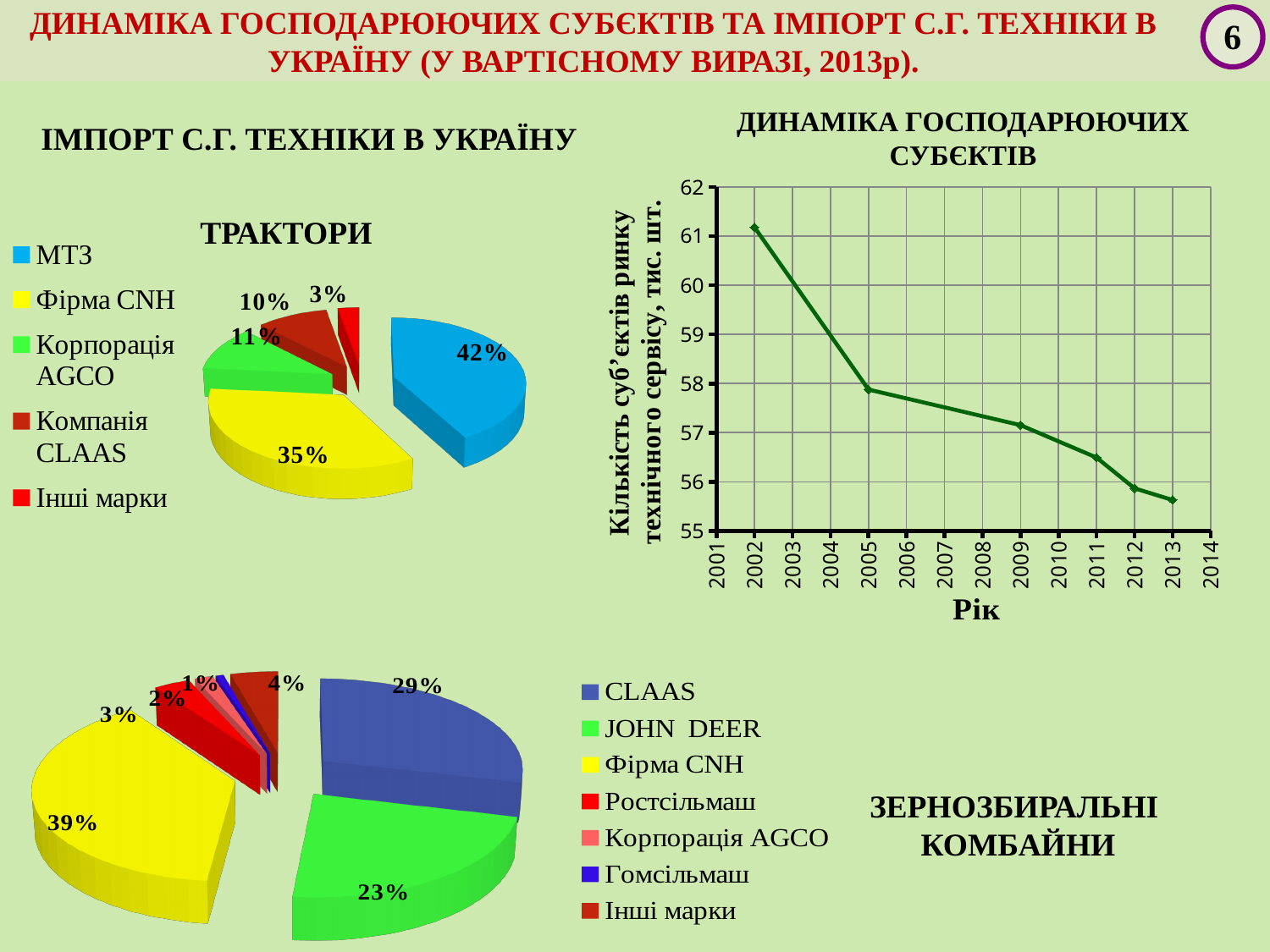
In the ТРАКТОРИ pie chart, what is the difference between the shares of МТЗ and Фірма CNH? 7% In the ЗЕРНОЗБИРАЛЬНІ КОМБАЙНИ pie chart, which brand has the largest share? Фірма CNH In the ДИНАМІКА ГОСПОДАРЮЮЧИХ СУБЄКТІВ chart, is the value for 2002 greater or less than 61? greater In the ЗЕРНОЗБИРАЛЬНІ КОМБАЙНИ pie chart, which is larger: the share of CLAAS or the share of JOHN DEER? CLAAS In the ДИНАМІКА ГОСПОДАРЮЮЧИХ СУБЄКТІВ chart, do the values rise or fall from 2002 to 2013? Fall In the ТРАКТОРИ pie chart, what share does Корпорація AGCO have? 11% How many entries does the legend of the ЗЕРНОЗБИРАЛЬНІ КОМБАЙНИ pie chart list? 7 In the ТРАКТОРИ pie chart, how many slices are there? 5 In the ЗЕРНОЗБИРАЛЬНІ КОМБАЙНИ pie chart, what share does Фірма CNH have? 39% In the ТРАКТОРИ pie chart, what share does МТЗ have? 42% In the ТРАКТОРИ pie chart, which brand has the smallest share? Інші марки What type of chart is the ДИНАМІКА ГОСПОДАРЮЮЧИХ СУБЄКТІВ chart? Line chart